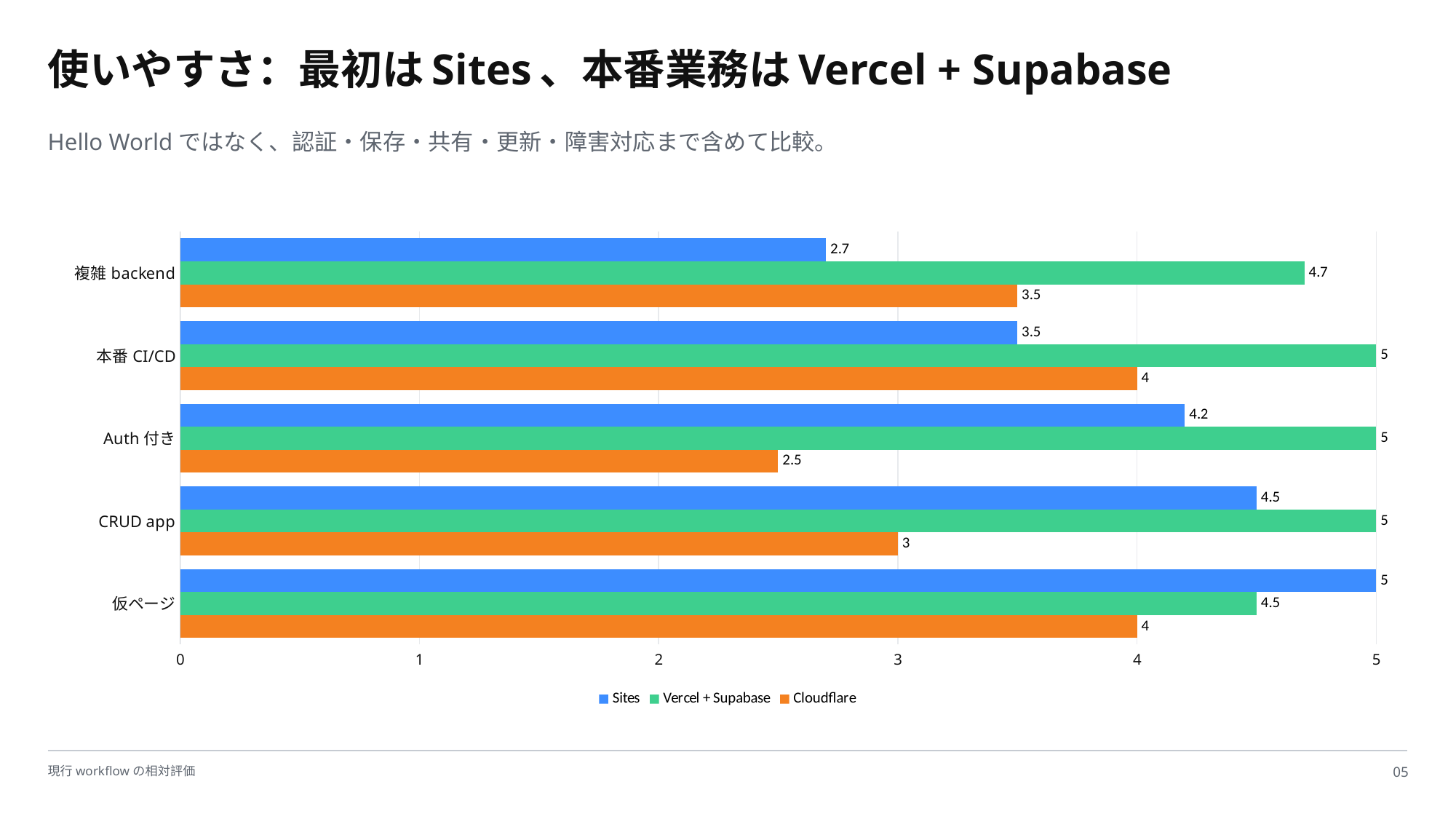
What is the difference between the Vercel + Supabase and Sites values in the 複雑 backend category? 2 How many categories are shown on the chart? 5 What is the value for Vercel + Supabase in the 仮ページ category? 4.5 Is the value for Cloudflare in the 複雑 backend category greater or less than 3? greater What is the value for Cloudflare in the Auth 付き category? 2.5 How many series does the legend list? 3 What is the value for Sites in the 複雑 backend category? 2.7 Which colour represents Cloudflare in the chart? Orange What kind of chart is shown on the slide? Bar chart Which is larger in the CRUD app category, Sites or Cloudflare? Sites Which category has the lowest value for Sites? 複雑 backend Which category has the highest value for Cloudflare? 本番 CI/CD and 仮ページ (both 4)